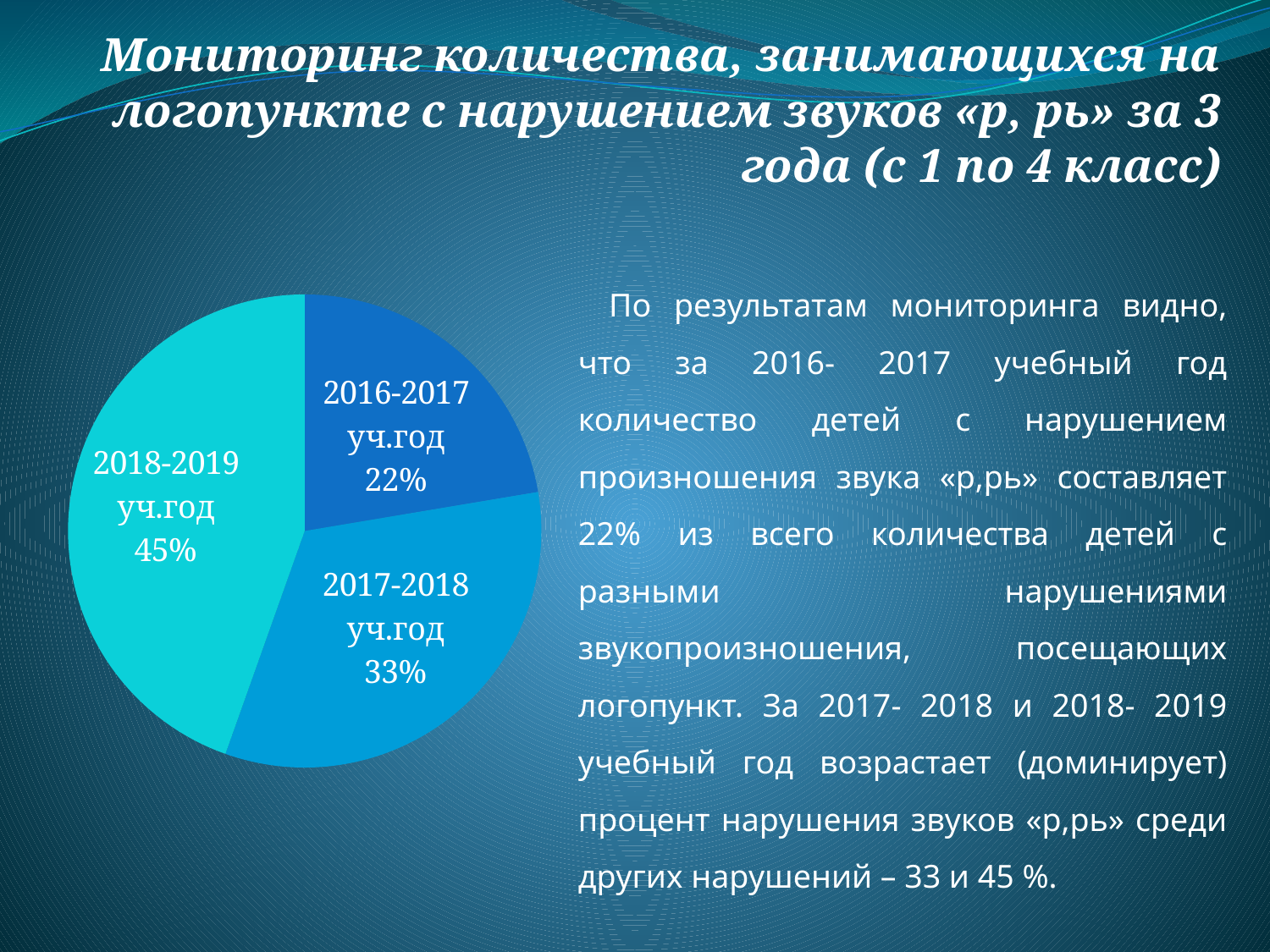
Which slice of the pie is the smallest? 2016-2017 уч.год How many slices does the pie chart have? 3 Which is larger, the 2017-2018 уч.год slice or the 2016-2017 уч.год slice? 2017-2018 уч.год Which slice of the pie is the largest? 2018-2019 уч.год What colour is the 2018-2019 уч.год slice? turquoise What share of the pie does the 2017-2018 уч.год slice have? 33% Do the slice percentages rise or fall from 2016-2017 to 2018-2019? rise What share of the pie does the 2016-2017 уч.год slice have? 22% What is the difference in percentage points between the 2017-2018 уч.год slice and the 2016-2017 уч.год slice? 11 What is the difference in percentage points between the 2018-2019 уч.год slice and the 2016-2017 уч.год slice? 23 What share of the pie does the 2018-2019 уч.год slice have? 45% What kind of chart is shown on the slide? pie chart